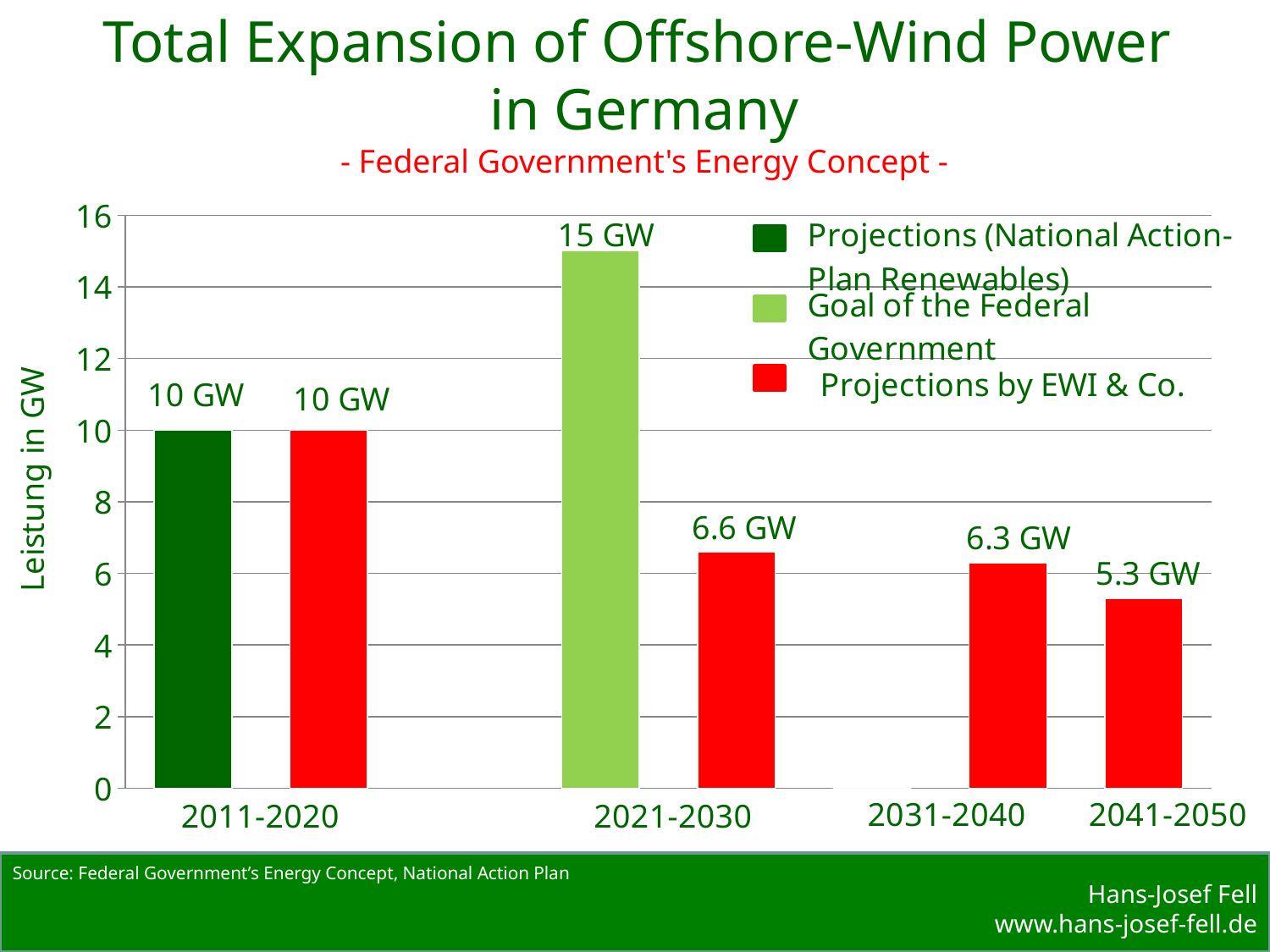
Which period has the lowest Projections by EWI & Co. value? 2041-2050 What is the difference between the Goal of the Federal Government and the Projections by EWI & Co. for 2021-2030? 8.4 GW Do the Projections by EWI & Co. values rise or fall from 2011-2020 to 2041-2050? Fall What is the value of the Projections by EWI & Co. bar for 2031-2040? 6.3 GW What kind of chart is shown on the slide? Bar chart What is the value of the Goal of the Federal Government bar for 2021-2030? 15 GW How many series does the legend list? 3 What is the value of the Projections by EWI & Co. bar for 2041-2050? 5.3 GW Is the Projections by EWI & Co. value for 2041-2050 greater or less than 6? less What is the value of the Projections (National Action-Plan Renewables) bar for 2011-2020? 10 GW Which bar has the highest value in the chart? Goal of the Federal Government, 2021-2030 (15 GW) Which is larger: the Projections by EWI & Co. for 2021-2030 or for 2031-2040? 2021-2030